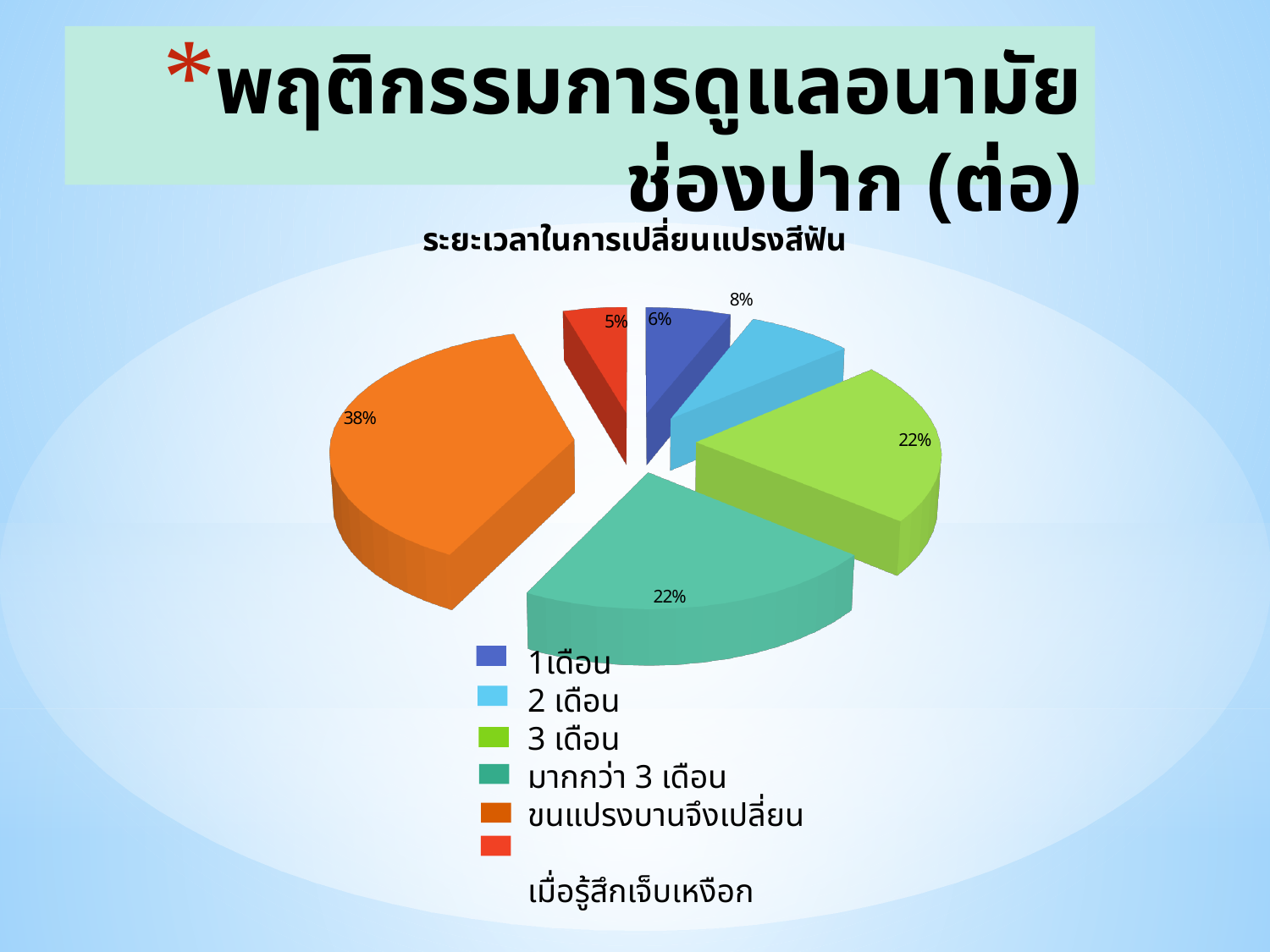
What percentage is shown for 3 เดือน? 22% Which is larger, the share for 2 เดือน or the share for 1 เดือน? 2 เดือน What percentage is shown for 1 เดือน? 6% What kind of chart is shown on the slide? pie chart What percentage is shown for เมื่อรู้สึกเจ็บเหงือก? 5% What is the difference in percentage points between ขนแปรงบานจึงเปลี่ยน and มากกว่า 3 เดือน? 16 What share of the pie is labelled for ขนแปรงบานจึงเปลี่ยน? 38% What percentage is shown for 2 เดือน? 8% How many slices does the pie chart have? 6 What is the title of the chart? ระยะเวลาในการเปลี่ยนแปรงสีฟัน Which category has the largest share of the pie? ขนแปรงบานจึงเปลี่ยน Which category has the smallest share of the pie? เมื่อรู้สึกเจ็บเหงือก